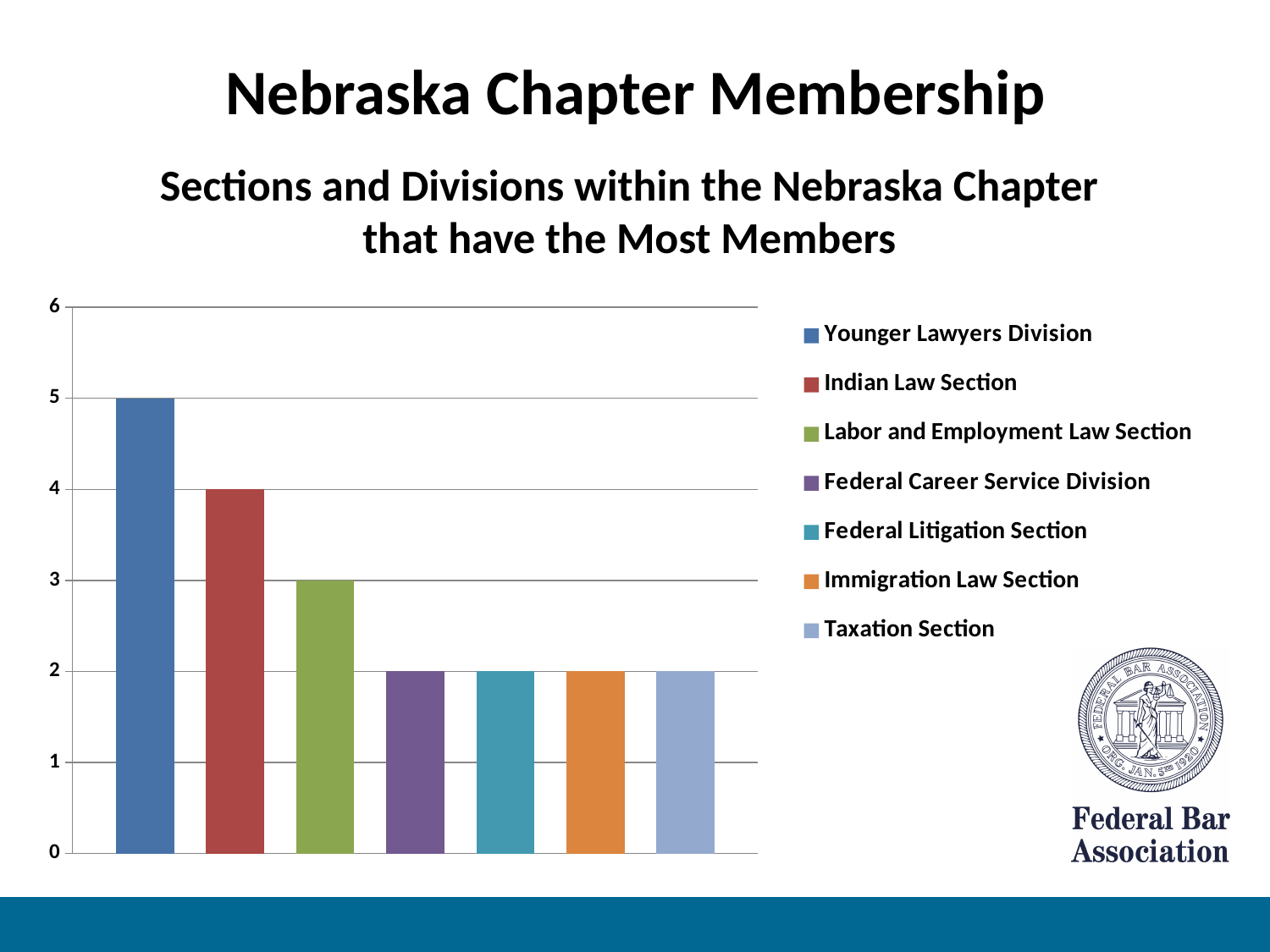
What is the value for the Indian Law Section? 4 What is the title of the chart? Sections and Divisions within the Nebraska Chapter that have the Most Members What is the difference between the values for the Younger Lawyers Division and the Indian Law Section? 1 Which is larger, the value for the Indian Law Section or the value for the Federal Litigation Section? Indian Law Section How many entries does the legend list? 7 What is the value for the Younger Lawyers Division? 5 How many bars are plotted in the chart? 7 What is the value for the Taxation Section? 2 Do the bar values rise or fall from left to right across the chart? fall What is the value for the Labor and Employment Law Section? 3 Which section or division has the highest value? Younger Lawyers Division What kind of chart is shown on the slide? bar chart